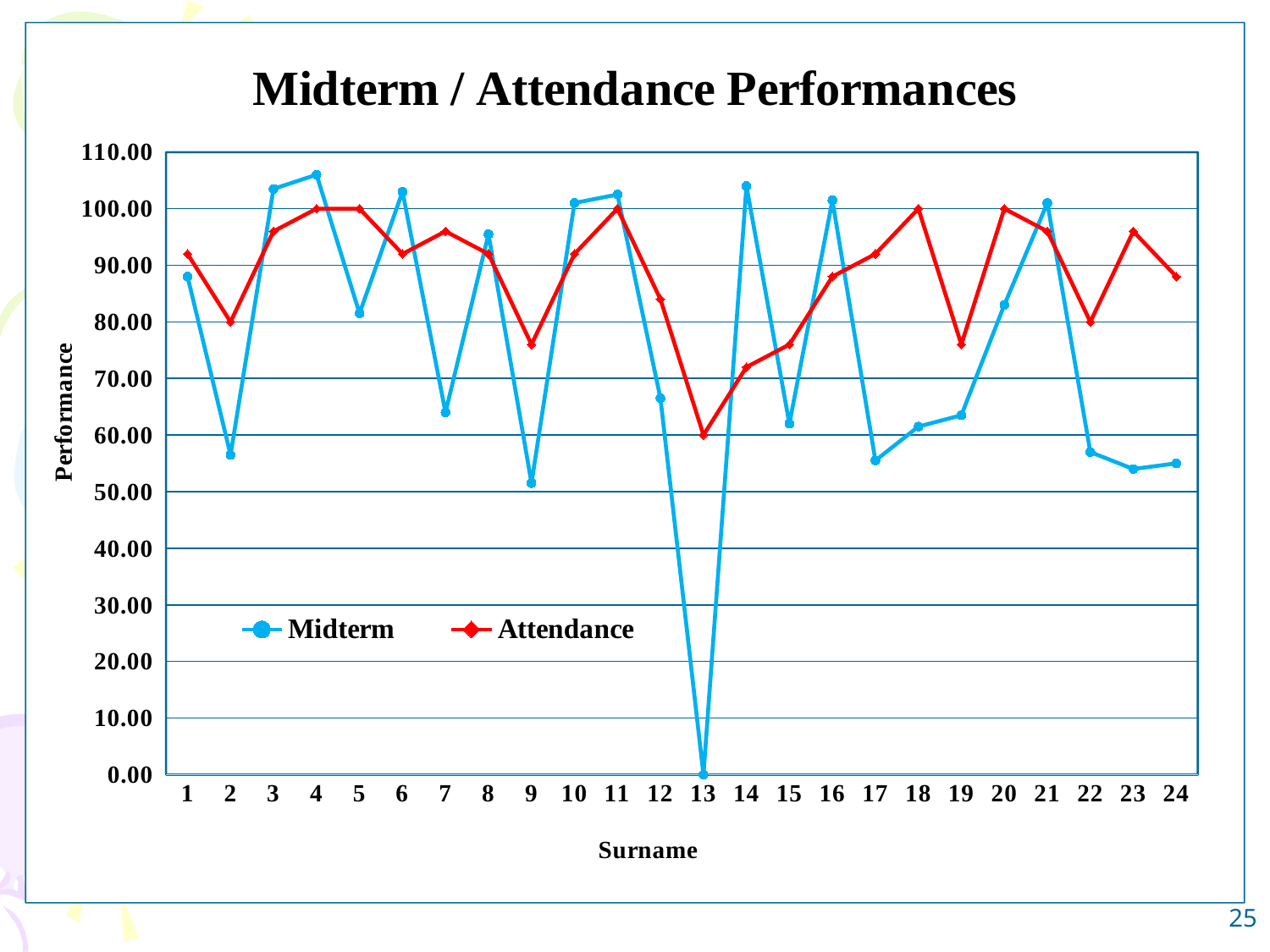
At category 7, which series has the larger value, Midterm or Attendance? Attendance What is the Attendance value for category 13? 60.00 How many categories are plotted along the x axis? 24 How many series does the legend list? 2 Which category has the lowest Attendance value? 13 Is the Attendance value for category 9 greater or less than 80.00? less Which category has the lowest Midterm value? 13 What kind of chart is shown on the slide? Line chart What is the Midterm value for category 13? 0.00 At category 4, which series has the larger value, Midterm or Attendance? Midterm Is the Midterm value for category 9 greater or less than 60.00? less What is the title of the chart? Midterm / Attendance Performances